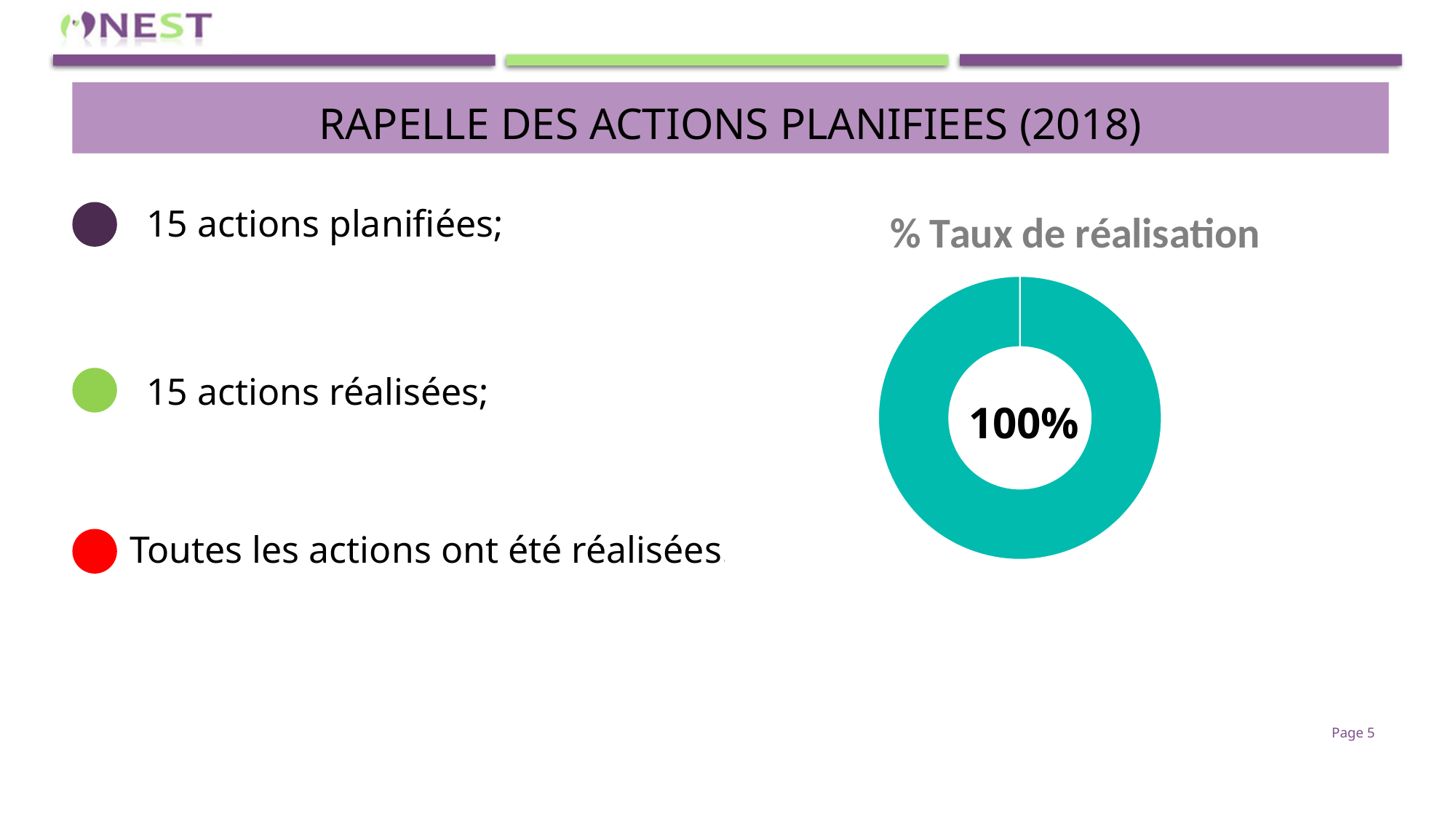
What kind of chart is shown on the slide? doughnut chart How many slices does the doughnut chart show? 1 What colour is the slice of the doughnut chart? teal Is the value shown in the doughnut chart greater or less than 50%? greater What is the title of the chart on the slide? % Taux de réalisation What share of the doughnut chart does the single teal slice occupy? 100% What value is printed in the centre of the doughnut chart? 100%